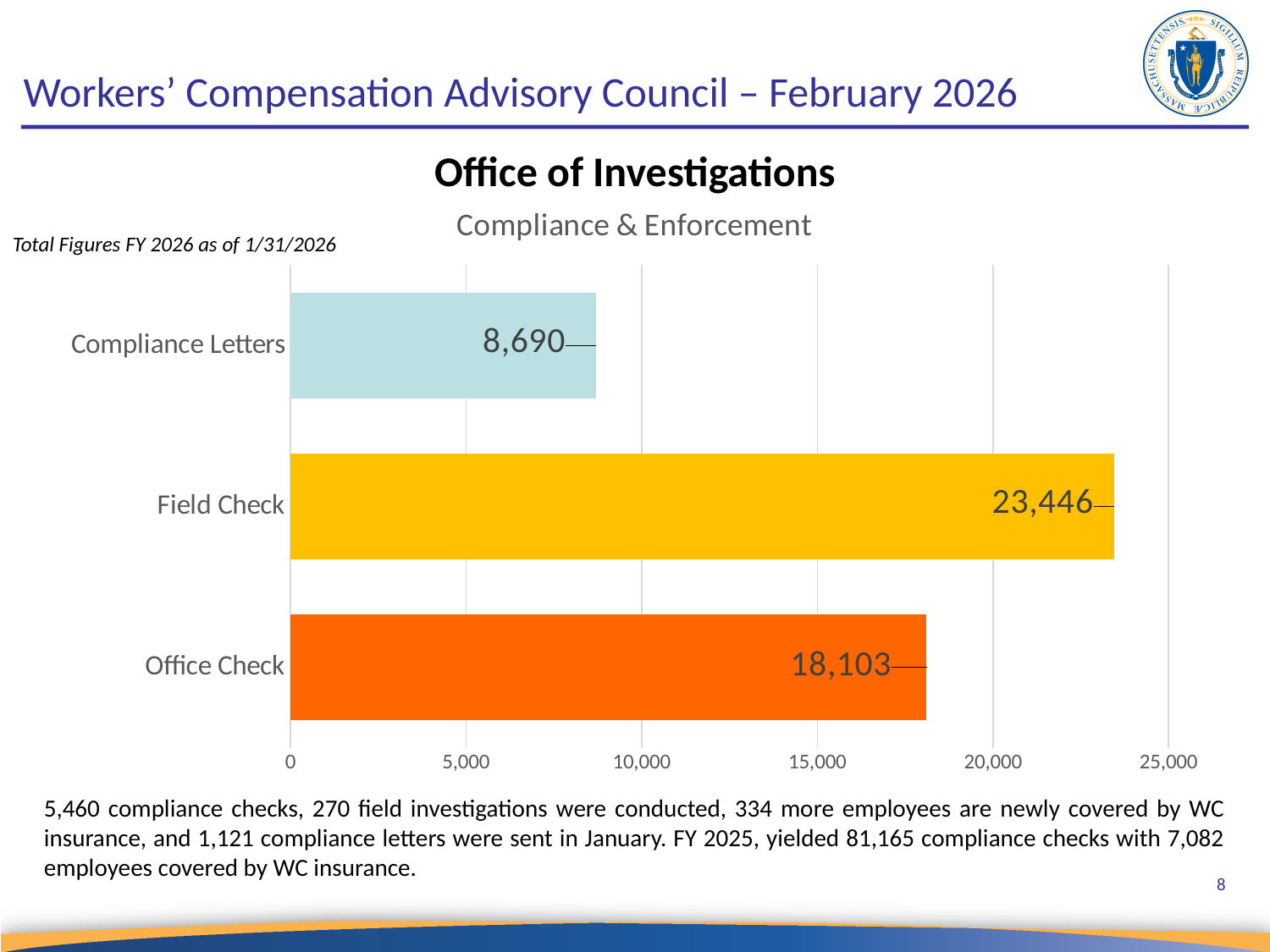
How many categories are shown in the chart? 3 Is the value for Field Check greater or less than 20,000? greater Which category has the highest value? Field Check What is the title of the chart? Compliance & Enforcement What is the difference between the Office Check and Compliance Letters values? 9,413 Which is larger, the value for Office Check or the value for Compliance Letters? Office Check What is the difference between the Field Check and Office Check values? 5,343 What is the value for Field Check? 23,446 What is the value for Office Check? 18,103 Which category has the lowest value? Compliance Letters What is the value for Compliance Letters? 8,690 What kind of chart is shown on the slide? Bar chart